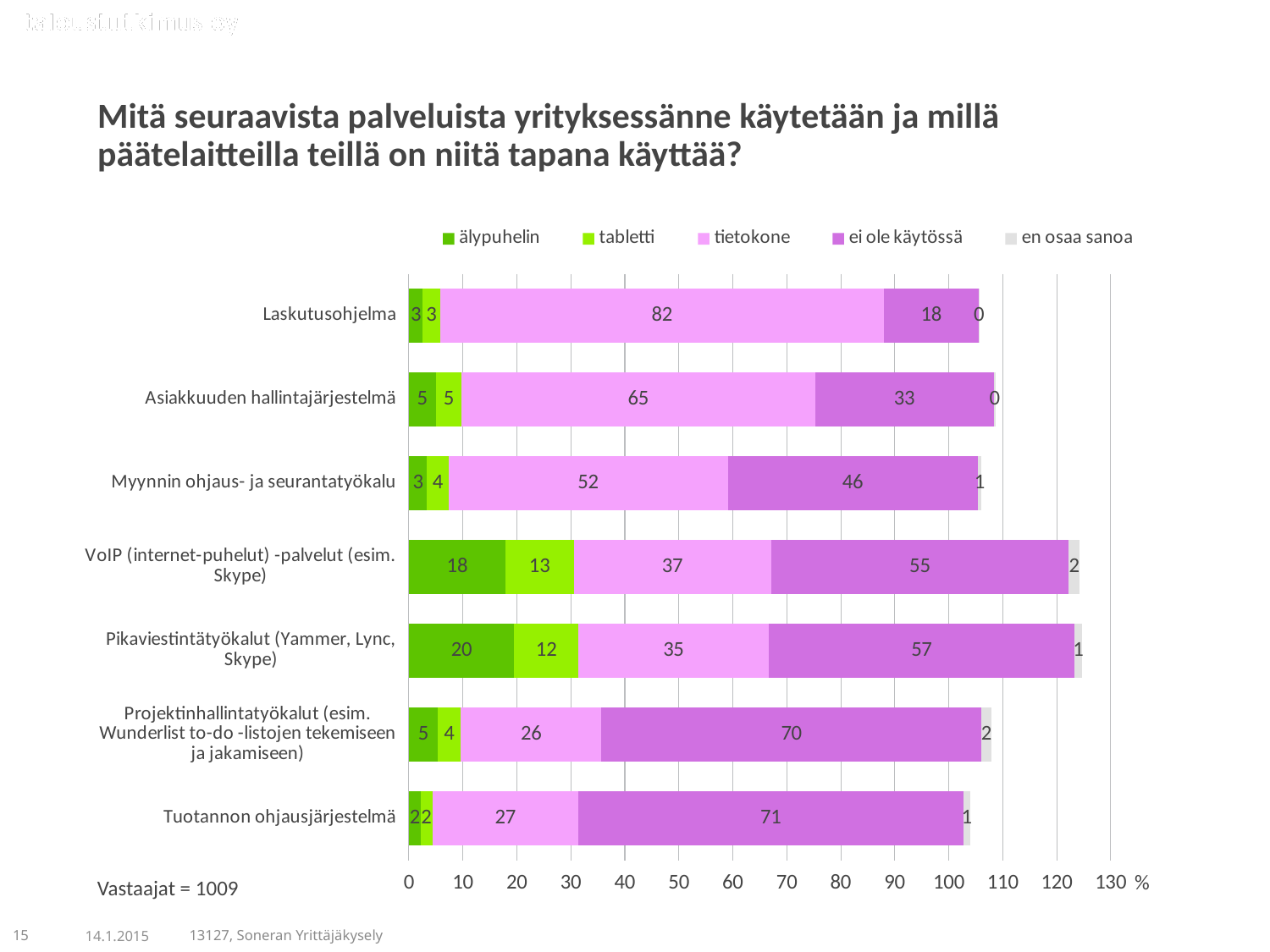
What is the 'älypuhelin' value for Pikaviestintätyökalut (Yammer, Lync, Skype)? 20 What is the difference between the 'ei ole käytössä' values for Tuotannon ohjausjärjestelmä and Laskutusohjelma? 53 What kind of chart is shown on the slide? Stacked bar chart Which is larger: the 'tabletti' value for VoIP (internet-puhelut) -palvelut (esim. Skype) or for Pikaviestintätyökalut (Yammer, Lync, Skype)? VoIP (internet-puhelut) -palvelut (esim. Skype) Which category has the highest 'tietokone' value? Laskutusohjelma Which category has the lowest 'ei ole käytössä' value? Laskutusohjelma What is the number of respondents (Vastaajat) stated on the slide? 1009 How many categories (services) are shown on the chart? 7 How many series does the legend list? 5 What is the 'ei ole käytössä' value for Projektinhallintatyökalut (esim. Wunderlist to-do -listojen tekemiseen ja jakamiseen)? 70 What is the total of the stacked bar for Asiakkuuden hallintajärjestelmä? 108 What is the 'tietokone' value for Laskutusohjelma? 82